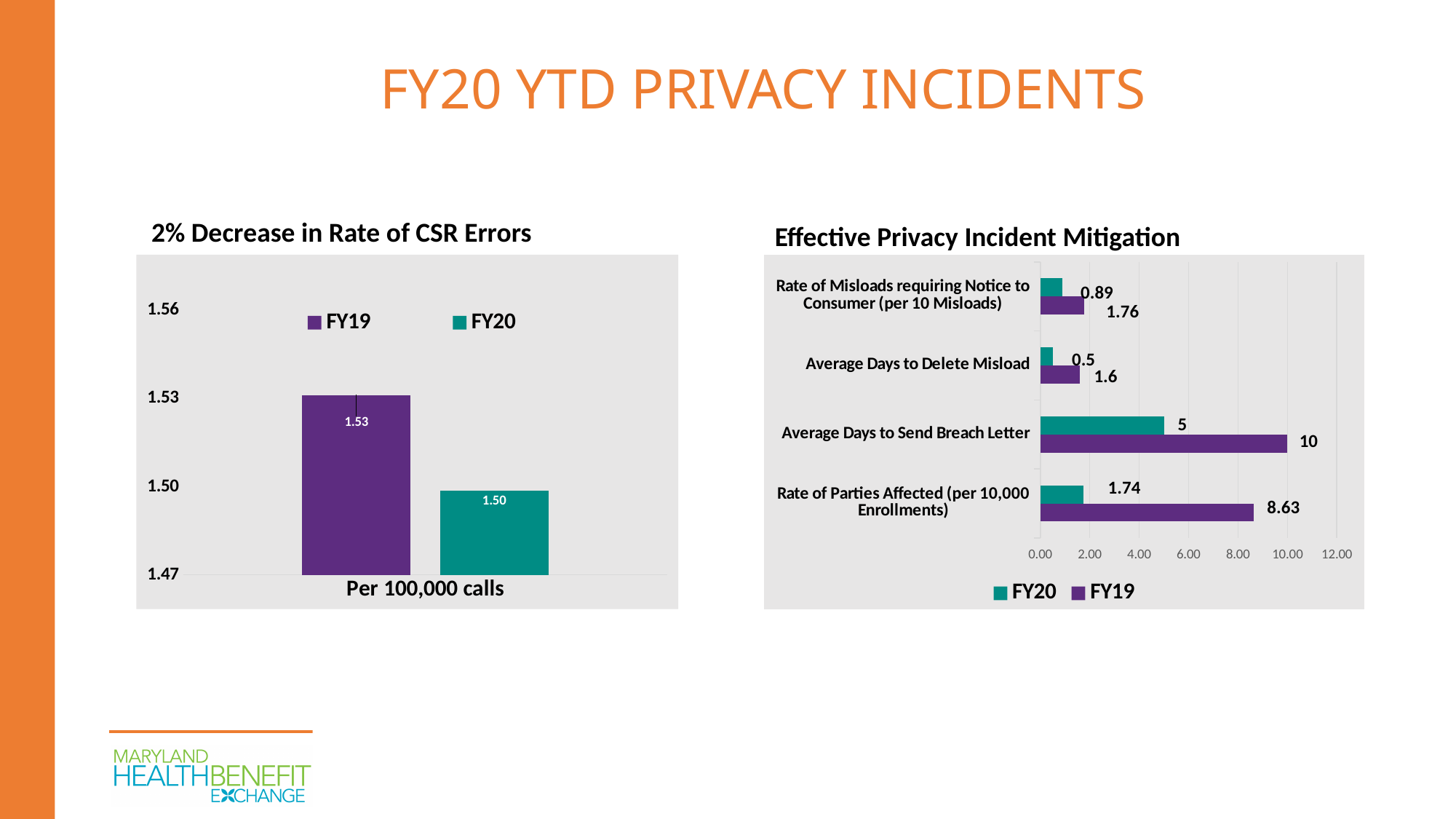
In the 'Effective Privacy Incident Mitigation' chart, what is the FY20 value for Average Days to Delete Misload? 0.5 In the 'Effective Privacy Incident Mitigation' chart, which category has the highest FY19 value? Average Days to Send Breach Letter In the '2% Decrease in Rate of CSR Errors' chart, what kind of chart is shown? Bar chart In the 'Effective Privacy Incident Mitigation' chart, what is the FY19 value for Average Days to Send Breach Letter? 10 In the 'Effective Privacy Incident Mitigation' chart, how many series does the legend list? 2 In the 'Effective Privacy Incident Mitigation' chart, what is the FY20 value for Rate of Parties Affected (per 10,000 Enrollments)? 1.74 In the '2% Decrease in Rate of CSR Errors' chart, what is the difference between the FY19 and FY20 values? 0.03 In the '2% Decrease in Rate of CSR Errors' chart, which series has the larger value, FY19 or FY20? FY19 In the 'Effective Privacy Incident Mitigation' chart, what is the difference between the FY19 and FY20 values for Rate of Parties Affected (per 10,000 Enrollments)? 6.89 In the '2% Decrease in Rate of CSR Errors' chart, what is the value for FY20? 1.50 In the '2% Decrease in Rate of CSR Errors' chart, what is the value for FY19? 1.53 In the 'Effective Privacy Incident Mitigation' chart, how many categories are shown? 4